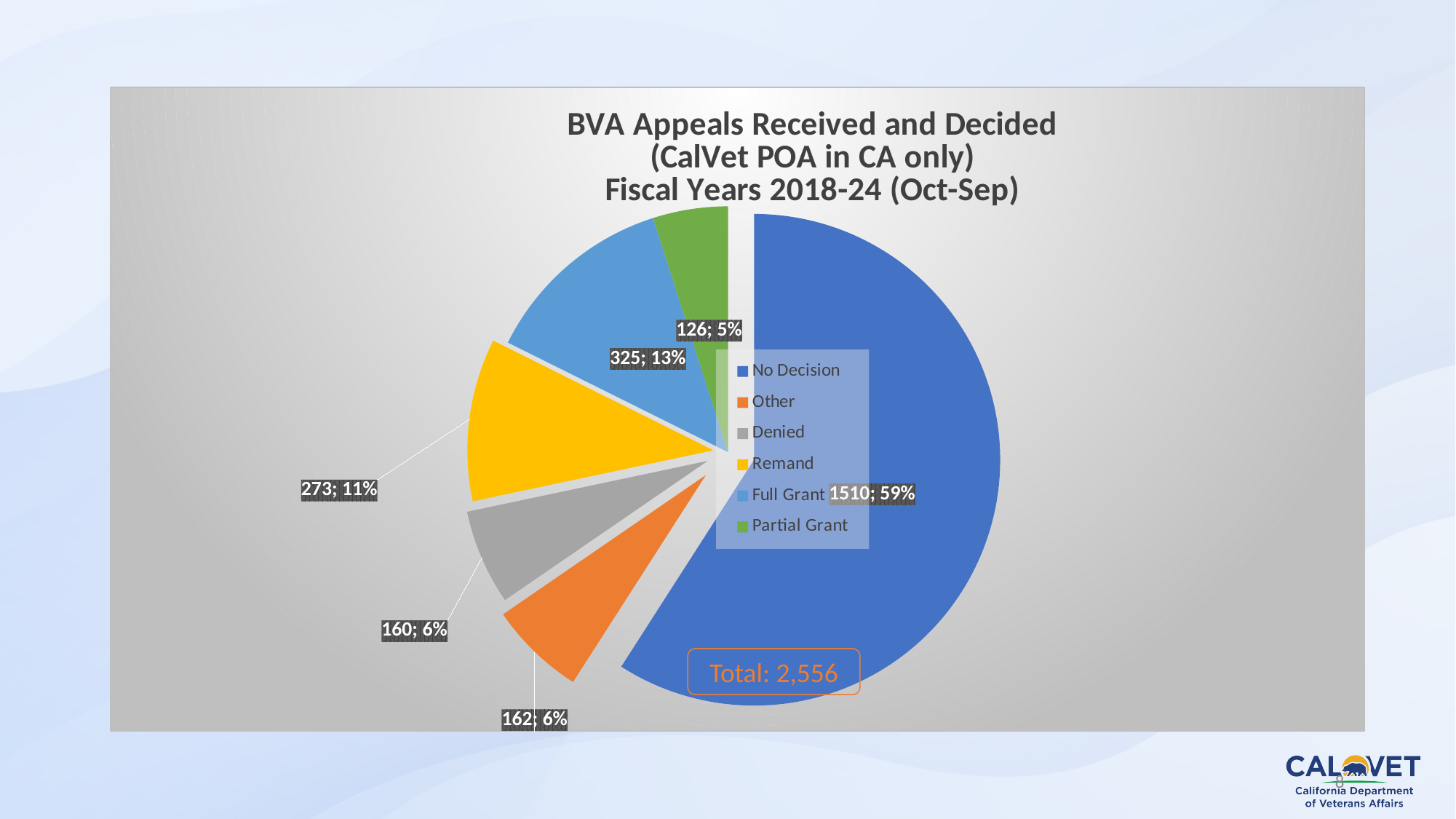
What share of the pie does Denied represent? 6% Which category has the smallest slice? Partial Grant What is the value shown for Remand? 273; 11% Which category has the largest slice? No Decision What is the value shown for Partial Grant? 126; 5% What is the value shown for Full Grant? 325; 13% What type of chart is shown on the slide? pie chart Which is larger, the Full Grant slice or the Partial Grant slice? Full Grant What total is shown in the box on the chart? Total: 2,556 What is the difference between the Full Grant count and the Remand count? 52 What is the value shown for No Decision? 1510; 59% How many categories does the legend list? 6